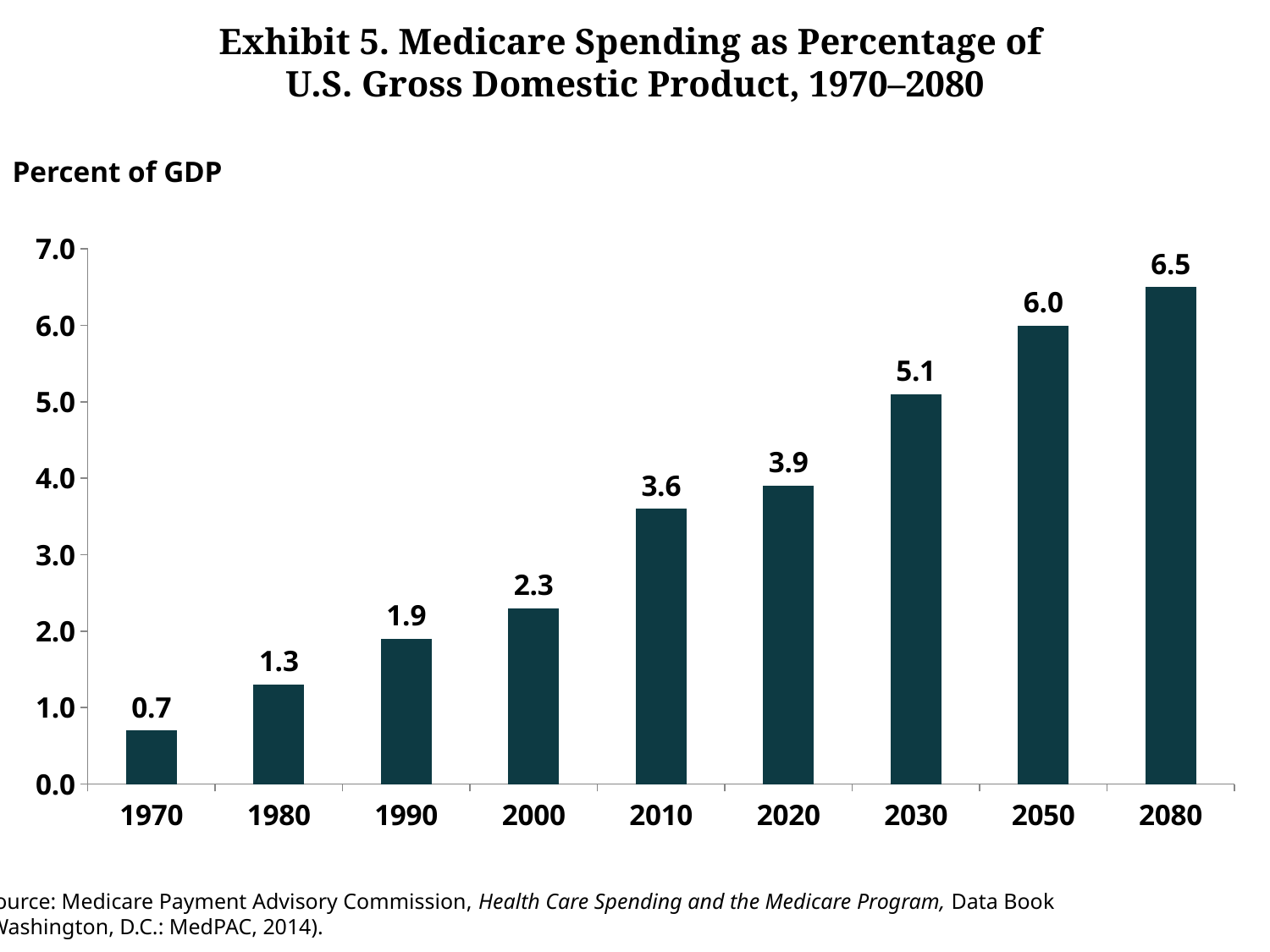
How many years are shown on the x axis? 9 What is the Medicare spending as a percentage of GDP for 1970? 0.7 Do the values rise or fall from 1970 to 2080? rise What kind of chart is shown on the slide? bar chart Which is larger, the value for 1990 or the value for 2000? 2000 Which year has the lowest Medicare spending as a percentage of GDP? 1970 What is the value shown for 2050? 6.0 Is the value for 2020 greater or less than 4.0? less What is the difference between the values for 2030 and 2020? 1.2 What is the value shown for 2010? 3.6 What is the difference between the values for 2080 and 1970? 5.8 Which year has the highest Medicare spending as a percentage of GDP? 2080